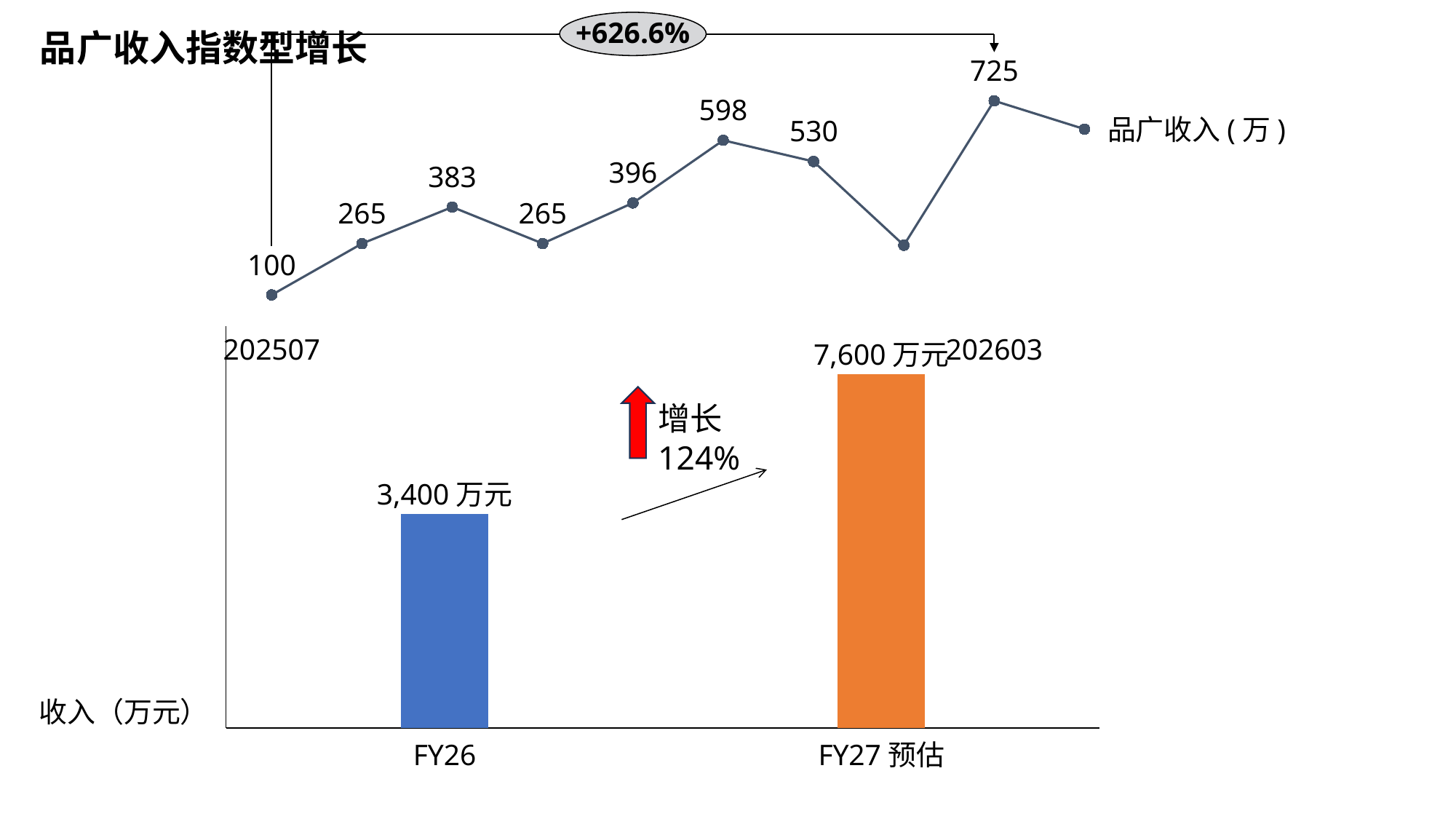
In the bottom bar chart, what is the value for FY27 预估? 7,600 万元 What kind of chart is the bottom chart on the slide? bar chart In the top line chart, what is the highest labeled value? 725 What percentage growth is shown in the oval annotation above the top line chart? +626.6% How many data points are plotted in the top line chart? 10 In the top line chart, what is the difference between the peak value 725 and the starting value 100? 625 In the bottom bar chart, what is the value for FY26? 3,400 万元 In the bottom bar chart, what is the difference between FY27 预估 and FY26? 4,200 万元 In the top line chart, what is the lowest value? 100 In the top line chart, which is larger, the point labeled 598 or the point labeled 530? 598 In the top line chart, what is the value of the first data point (202507)? 100 In the bottom bar chart, what growth percentage is shown between FY26 and FY27 预估? 124%